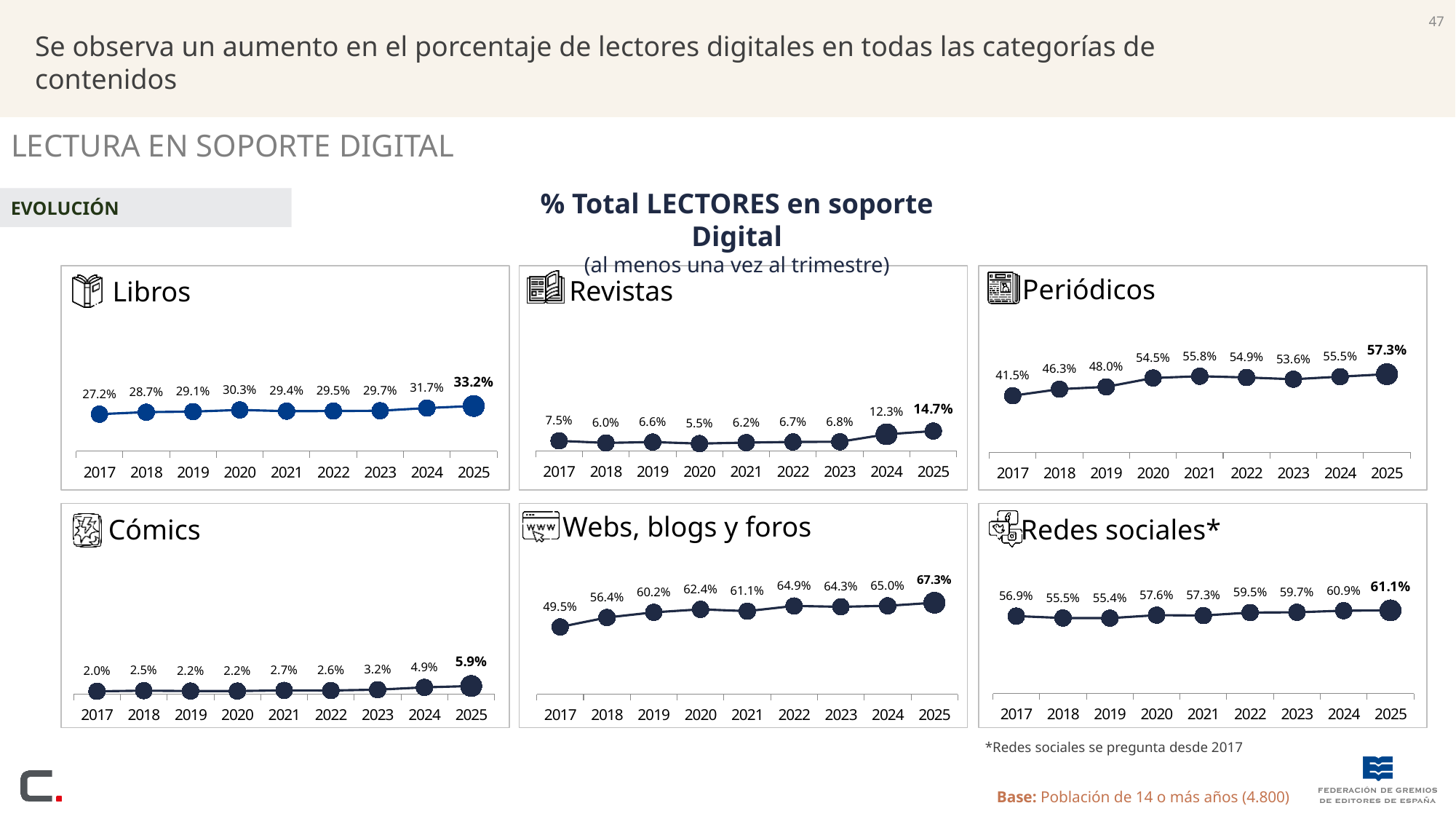
In the Periódicos chart, do the values generally rise or fall from 2017 to 2025? Rise In the Redes sociales chart, which year has the larger value, 2017 or 2018? 2017 In the Libros chart, what is the value for 2025? 33.2% What kind of chart is the Periódicos chart? Line chart In the Redes sociales chart, what is the value for 2022? 59.5% How many charts are shown on the slide? 6 In the Revistas chart, what is the value for 2020? 5.5% In the Periódicos chart, which year has the highest value? 2025 In the Webs, blogs y foros chart, what is the difference between the 2025 value and the 2017 value? 17.8 percentage points In the Revistas chart, by how much did the value increase from 2024 to 2025? 2.4 percentage points In the Cómics chart, which year has the lowest value? 2017 In the Libros chart, how many years are plotted on the x axis? 9